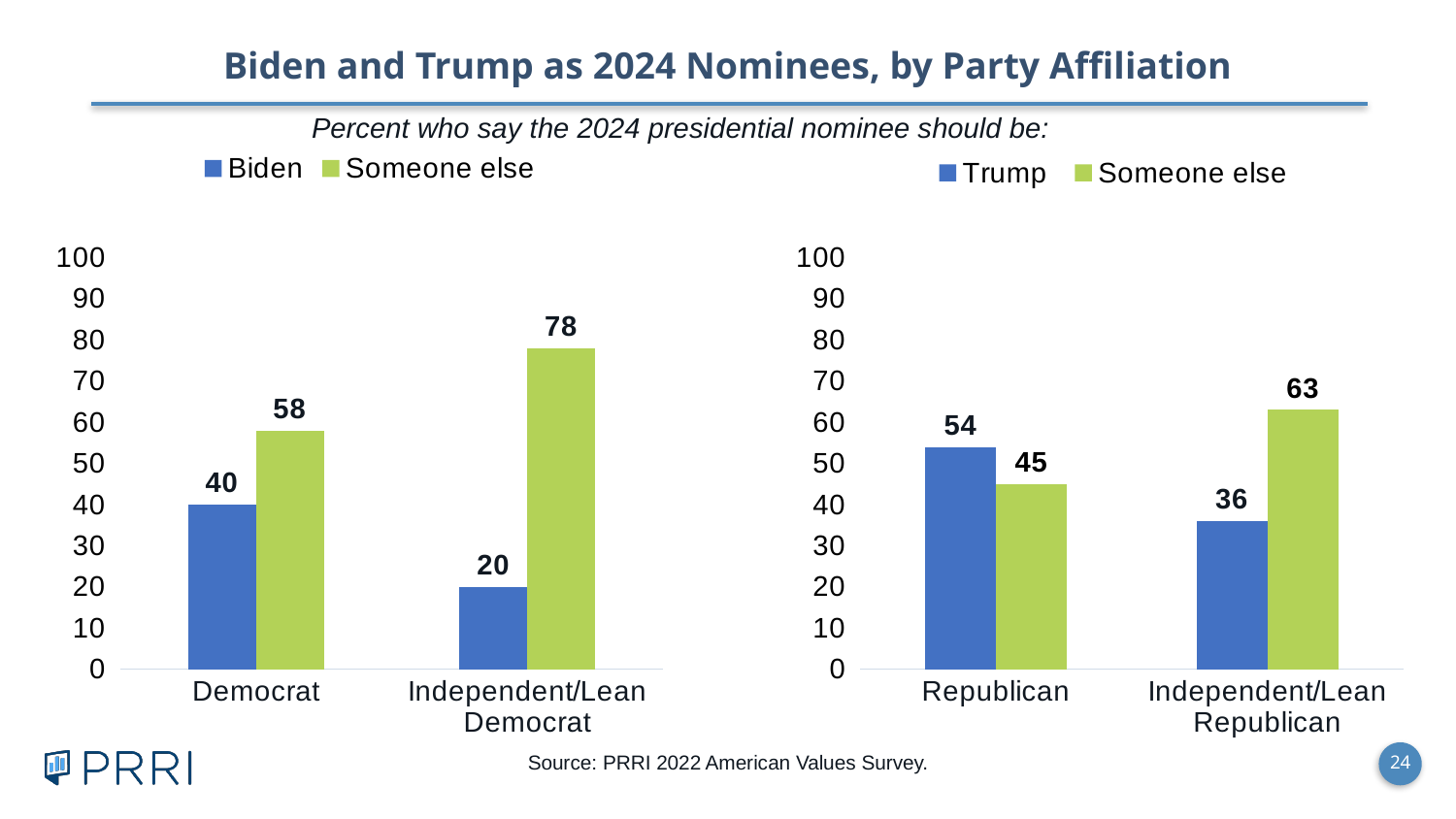
What type of chart is the left chart? Bar chart In the left chart (Biden), what percent of Independent/Lean Democrat respondents say the nominee should be someone else? 78 In the left chart (Biden), what is the difference between the Someone else and Biden values for Democrats? 18 In the right chart (Trump), which bar is the lowest? Trump, Independent/Lean Republican How many series does the legend of the left chart list? 2 How many categories are shown on the x axis of the right chart? 2 In the right chart (Trump), which is larger for Republicans: Trump or Someone else? Trump In the right chart (Trump), what percent of Independent/Lean Republican respondents say the nominee should be someone else? 63 In the left chart (Biden), which bar is the highest? Someone else, Independent/Lean Democrat In the right chart (Trump), what percent of Republicans say the 2024 nominee should be Trump? 54 In the right chart (Trump), what is the difference between the Trump and Someone else values for Republicans? 9 In the left chart (Biden), what percent of Democrats say the 2024 nominee should be Biden? 40